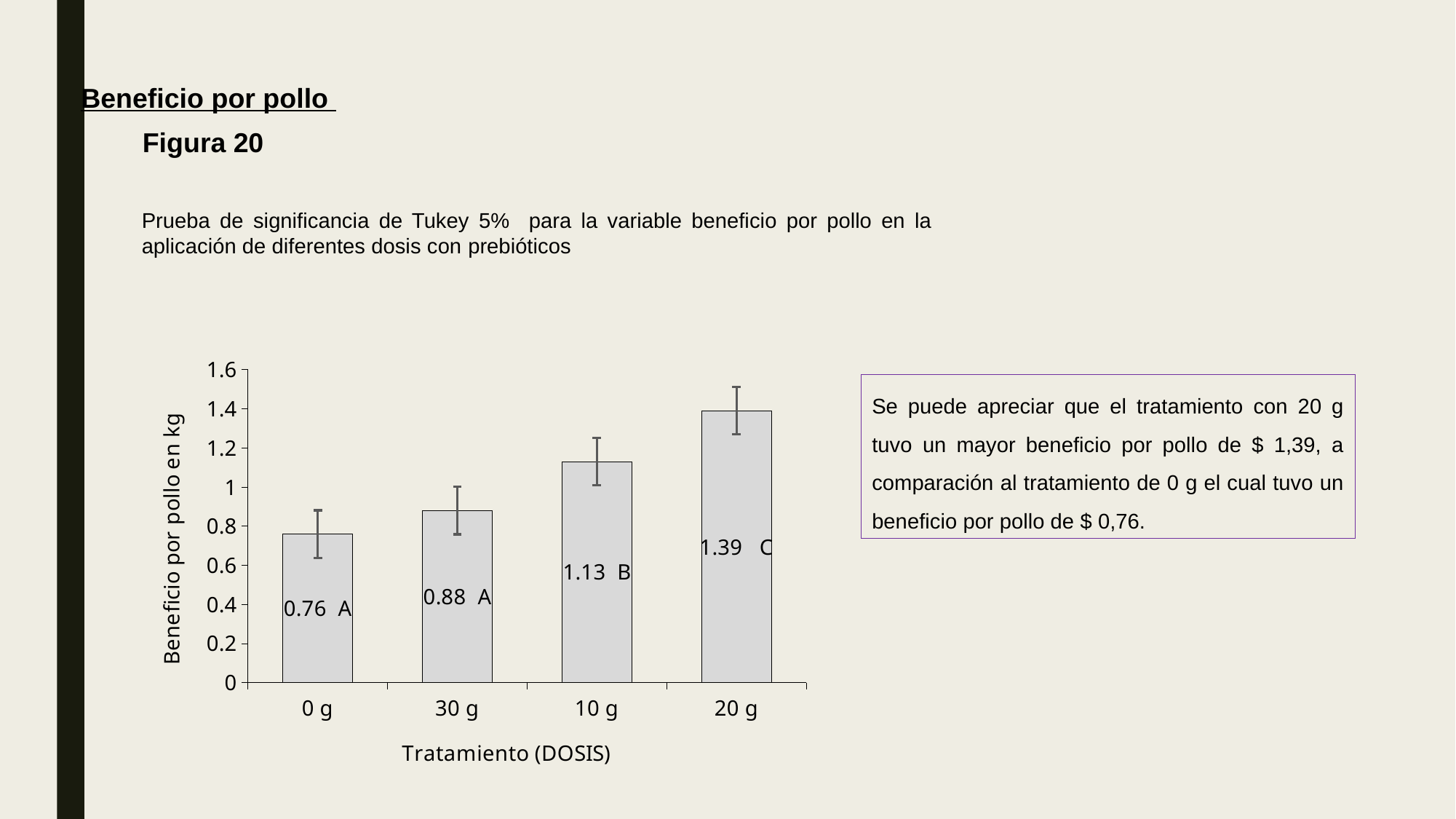
What is the difference between the values for 20 g and 0 g? 0.63 Which treatment has the lowest beneficio por pollo? 0 g What is the difference between the values for 10 g and 30 g? 0.25 What is the value for the 30 g treatment? 0.88 What is the value for the 0 g treatment? 0.76 Which is larger, the value for 10 g or the value for 30 g? 10 g What is the value for the 20 g treatment? 1.39 What is the label of the y axis? Beneficio por pollo en kg What is the value for the 10 g treatment? 1.13 Which treatment has the highest beneficio por pollo? 20 g How many treatment categories are shown on the x axis? 4 What kind of chart is shown on the slide? Bar chart